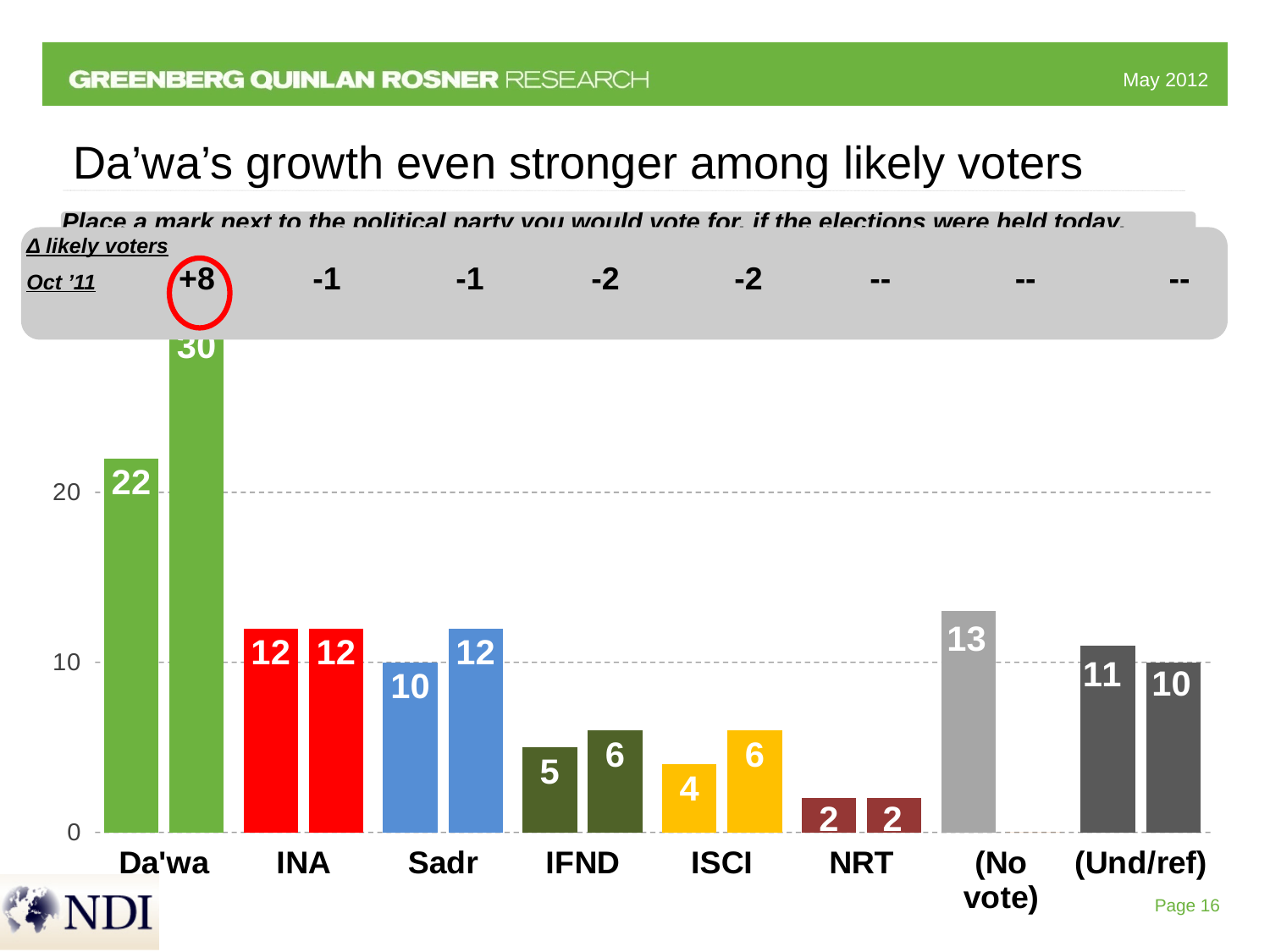
Which category has the tallest bar in the chart? Da'wa What is the value of the taller (right) bar for Da'wa? 30 How many categories are shown on the x axis? 8 What type of chart is shown on the slide? bar chart What is the value of the right bar for Sadr? 12 Which category has the lowest bars in the chart? NRT What change is shown for Da'wa in the 'Δ likely voters' row at the top of the chart? +8 What is the difference between the right bar and the left bar for Da'wa? 8 Which is larger: the left bar for (Und/ref) or the right bar for (Und/ref)? the left bar (11) What is the value of the left bar for ISCI? 4 What is the value shown for (No vote)? 13 What is the value of the left bar for Da'wa? 22